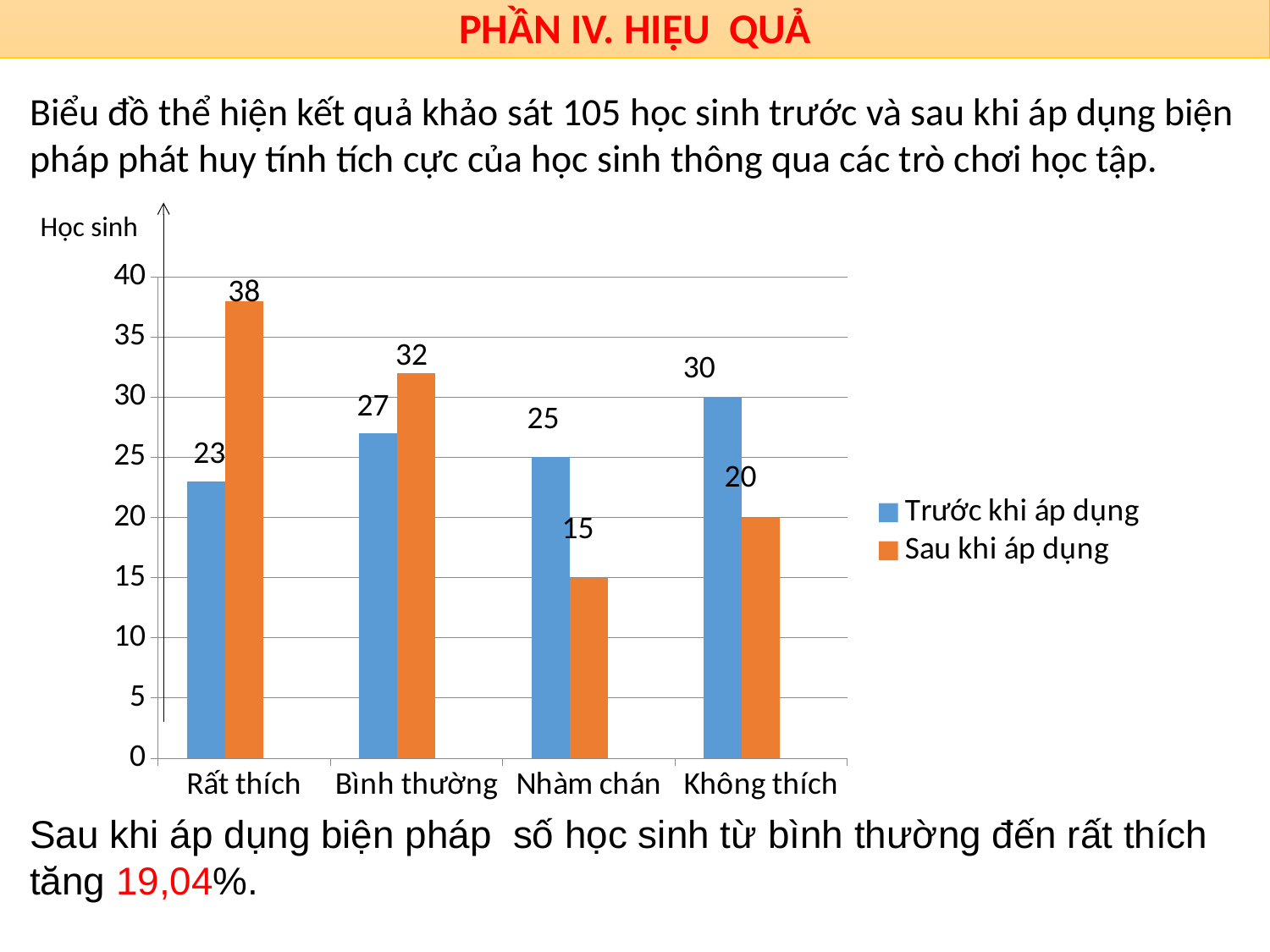
What kind of chart is shown on the slide? bar chart What is the value for "Không thích" in the "Trước khi áp dụng" series? 30 How many categories are shown on the x axis? 4 What is the label on the vertical axis of the chart? Học sinh Which category has the lowest value in the "Trước khi áp dụng" series? Rất thích Which is larger for "Không thích": the "Trước khi áp dụng" value or the "Sau khi áp dụng" value? Trước khi áp dụng Which category has the highest value in the "Sau khi áp dụng" series? Rất thích Is the "Sau khi áp dụng" value for "Bình thường" greater or less than 30? greater What is the difference between the "Sau khi áp dụng" and "Trước khi áp dụng" values for "Rất thích"? 15 What is the value for "Rất thích" in the "Sau khi áp dụng" series? 38 What is the value for "Nhàm chán" in the "Sau khi áp dụng" series? 15 How many series does the legend list? 2